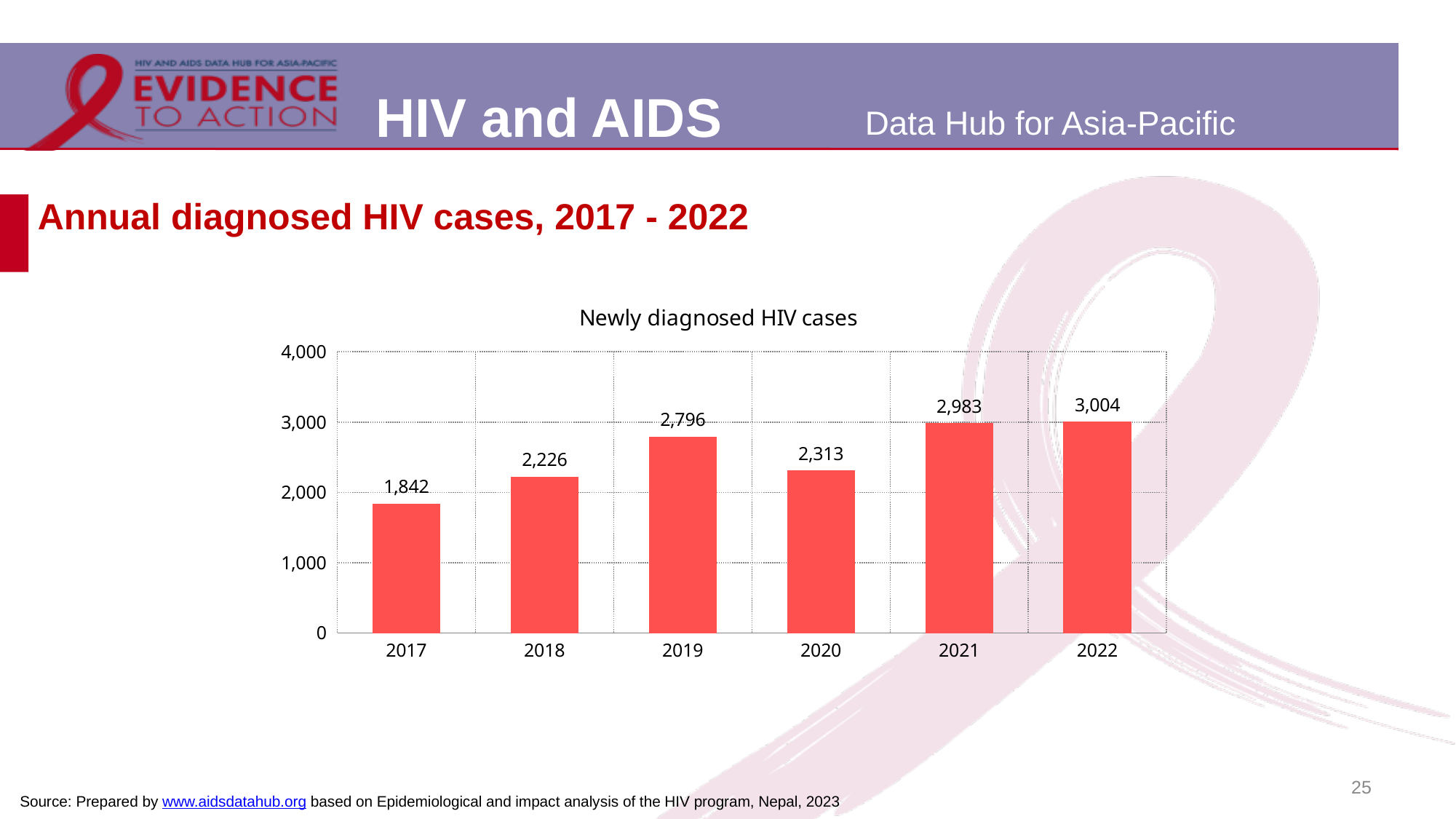
What is the difference in newly diagnosed HIV cases between 2019 and 2020? 483 Is the value for 2021 greater or less than 2,000? greater What is the number of newly diagnosed HIV cases in 2022? 3,004 What is the number of newly diagnosed HIV cases in 2017? 1,842 What kind of chart is used to show newly diagnosed HIV cases? Bar chart Which year has the lowest number of newly diagnosed HIV cases? 2017 How many years are shown on the x axis of the chart? 6 What is the number of newly diagnosed HIV cases in 2020? 2,313 Which year has the highest number of newly diagnosed HIV cases? 2022 What is the difference in newly diagnosed HIV cases between 2018 and 2017? 384 Which year had more newly diagnosed HIV cases, 2019 or 2020? 2019 What is the title of the chart? Newly diagnosed HIV cases